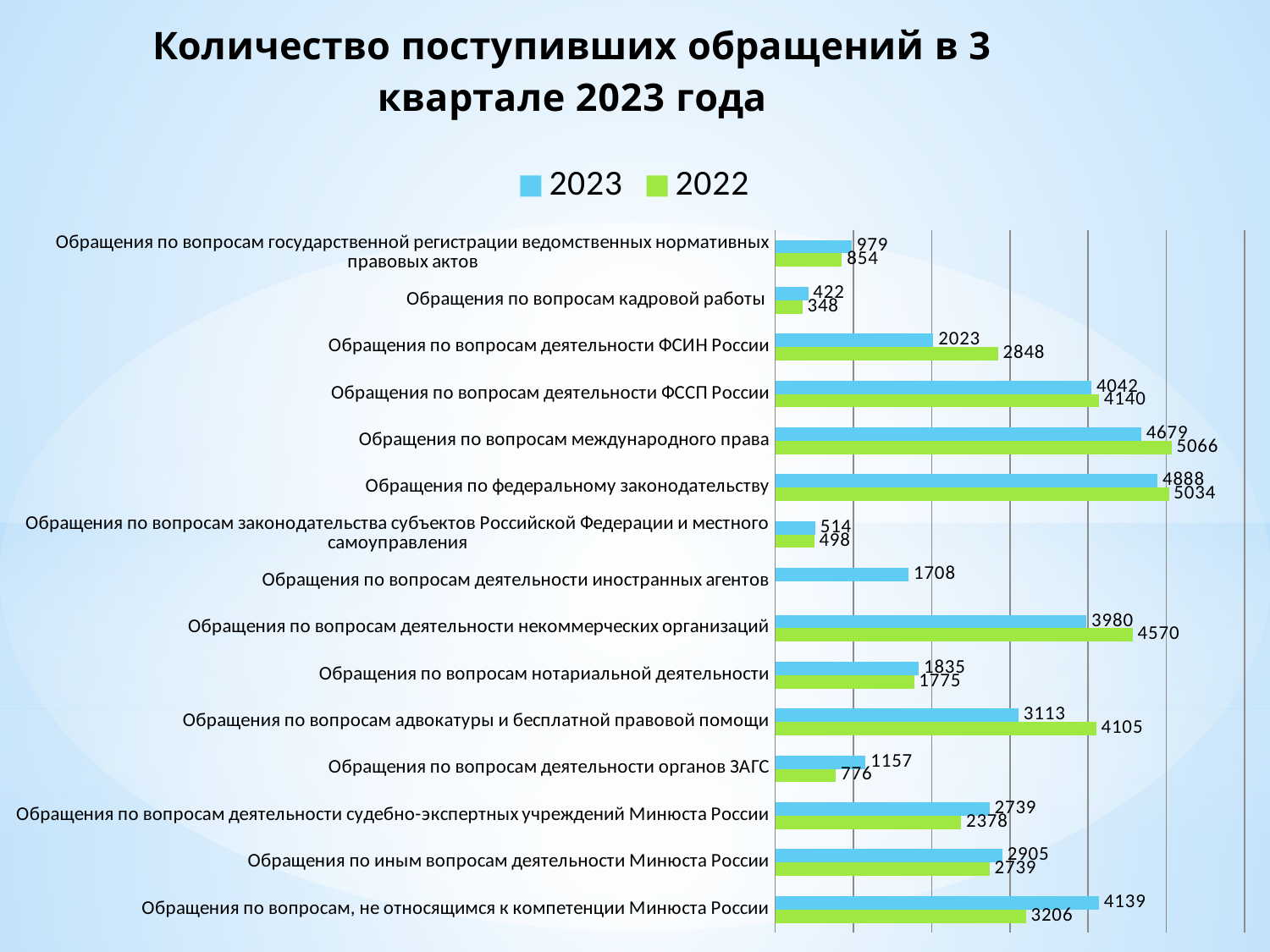
What is the 2023 value for «Обращения по вопросам деятельности иностранных агентов»? 1708 What is the difference between the 2022 and 2023 values for «Обращения по вопросам деятельности некоммерческих организаций»? 590 How many series does the legend list? 2 What is the difference between the 2023 and 2022 values for «Обращения по вопросам, не относящимся к компетенции Минюста России»? 933 What type of chart is shown on the slide? bar chart How many categories are shown on the chart? 15 Which category has the lowest 2022 value? Обращения по вопросам кадровой работы For «Обращения по вопросам деятельности органов ЗАГС», which year has the larger value, 2023 or 2022? 2023 What is the 2023 value for «Обращения по вопросам деятельности ФСИН России»? 2023 What is the 2022 value for «Обращения по вопросам адвокатуры и бесплатной правовой помощи»? 4105 Which colour represents the 2022 series in the legend? green Which category has the highest 2023 value? Обращения по федеральному законодательству